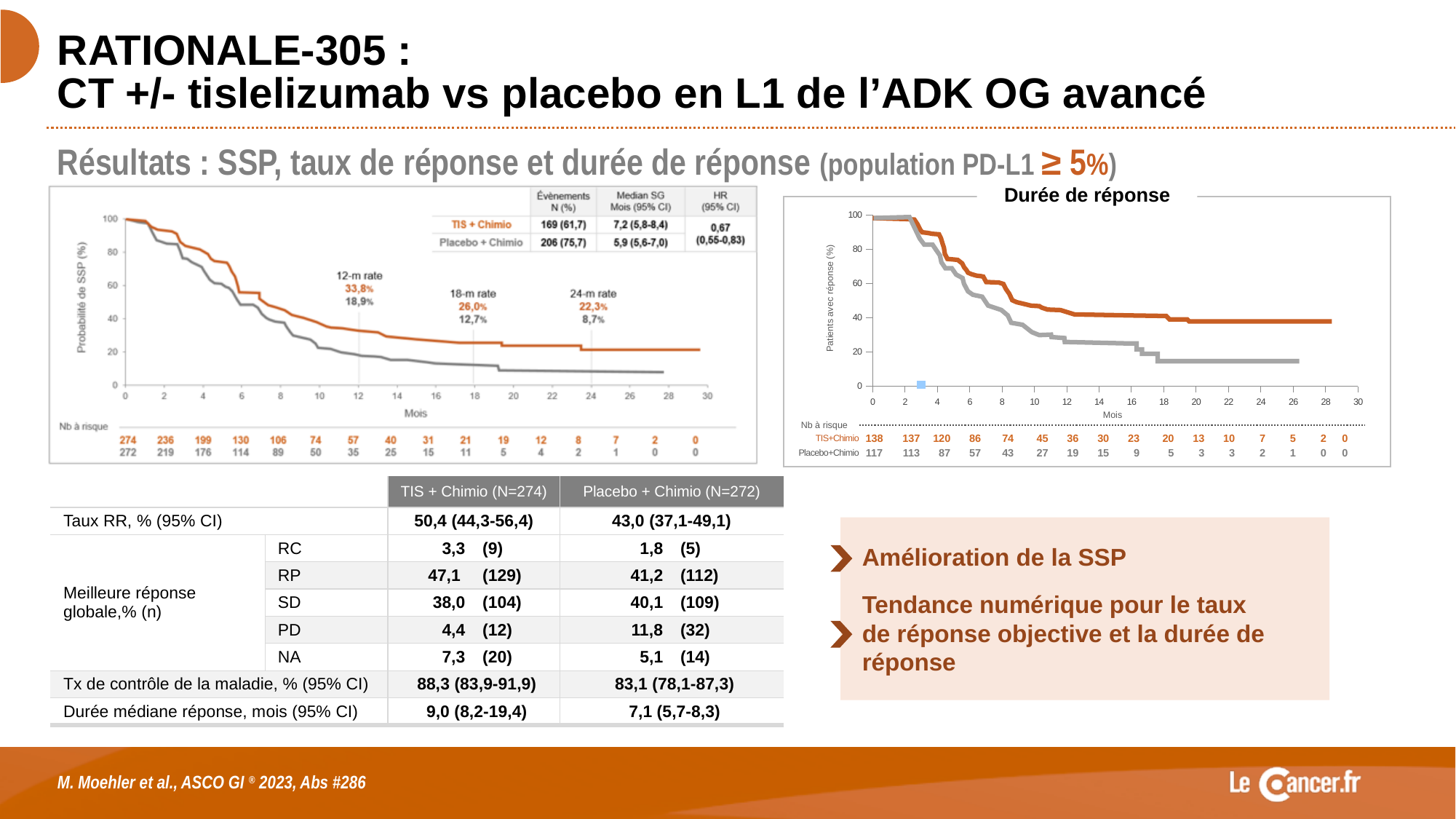
On the left SSP chart, how many TIS + Chimio patients are at risk at 12 months? 57 On the left SSP chart, what is the 24-m rate for Placebo + Chimio? 8,7% On the 'Durée de réponse' chart, how many Placebo+Chimio patients are at risk at 0 months? 117 What kind of chart is the 'Durée de réponse' chart on the right? Kaplan-Meier survival curve (line chart) On the left SSP chart, what is the median in months (95% CI) for Placebo + Chimio? 5,9 (5,6-7,0) On the 'Durée de réponse' chart, how many TIS+Chimio patients are at risk at 8 months? 74 On the 'Durée de réponse' chart, is the Placebo+Chimio curve at 20 months greater or less than 20? less On the left SSP chart, what is the HR (95% CI) shown in the table? 0,67 (0,55-0,83) On the left SSP chart, what is the 12-m rate for TIS + Chimio? 33,8% On the 'Durée de réponse' chart, do the curves rise or fall as months increase? fall On the left SSP chart, which arm has the higher 24-m rate? TIS + Chimio On the left SSP chart, what is the difference between the 18-m rates of TIS + Chimio and Placebo + Chimio? 13,3 points